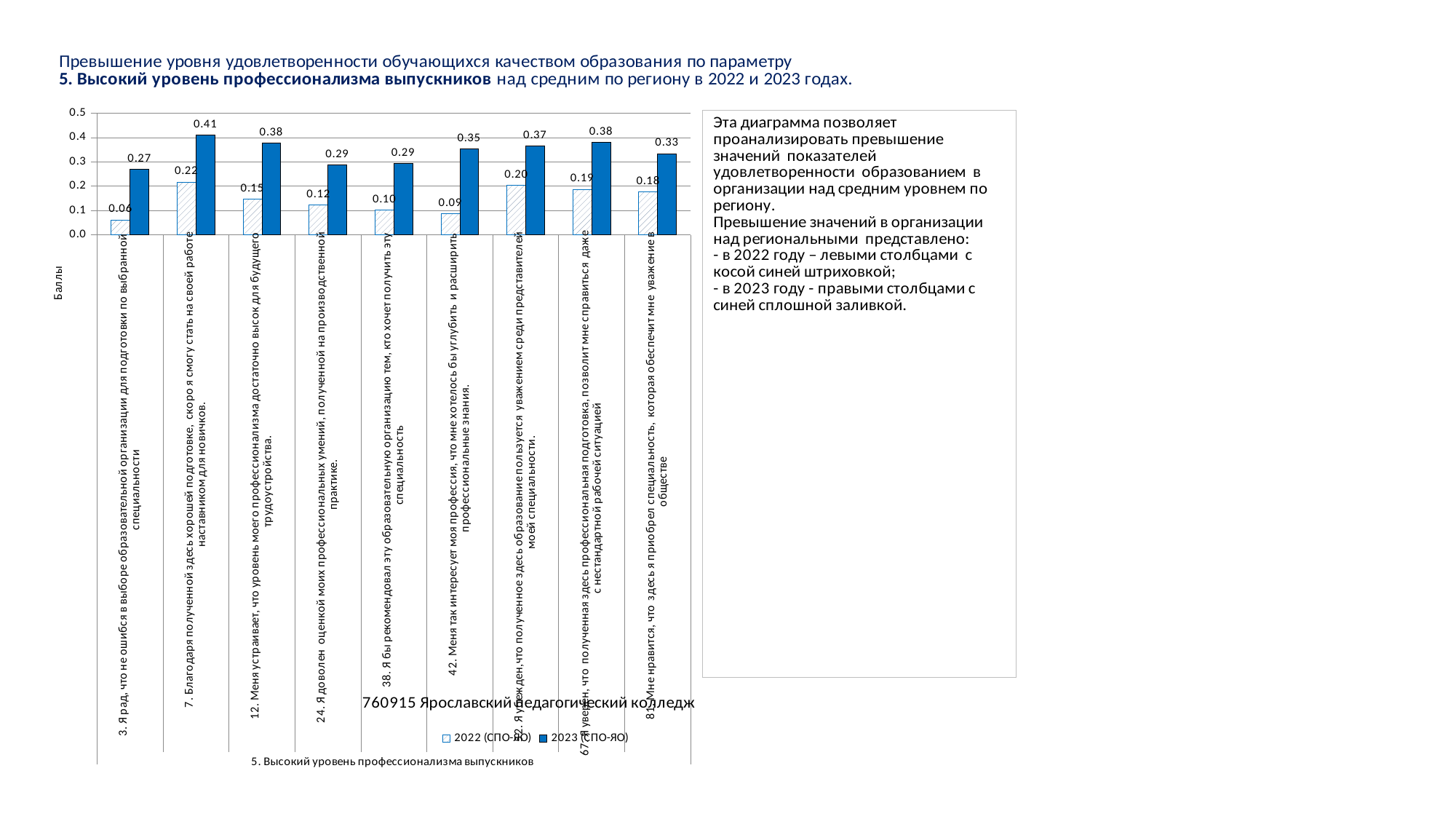
Which statement has the highest 2023 (СПО-ЯО) value? 7. Благодаря полученной здесь хорошей подготовке, скоро я смогу стать на своей работе наставником для новичков. Which is larger: the 2022 (СПО-ЯО) value for statement 52 or the 2022 (СПО-ЯО) value for statement 24? statement 52 What is the difference between the 2023 and 2022 (СПО-ЯО) values for statement 42? 0.26 How many statement categories are plotted on the x axis of the chart? 9 What is the 2022 (СПО-ЯО) value for statement 3 ("Я рад, что не ошибся в выборе образовательной организации...")? 0.06 How many series does the chart legend list? 2 What is the 2023 (СПО-ЯО) value for statement 7 ("Благодаря полученной здесь хорошей подготовке, скоро я смогу стать на своей работе наставником для новичков")? 0.41 Which statement has the lowest 2022 (СПО-ЯО) value? 3. Я рад, что не ошибся в выборе образовательной организации для подготовки по выбранной специальности What is the label of the vertical axis of the chart? Баллы What type of chart is shown on the slide? bar chart Is the 2023 (СПО-ЯО) value for statement 81 greater or less than 0.3? greater What is the 2023 (СПО-ЯО) value for statement 42 ("Меня так интересует моя профессия...")? 0.35